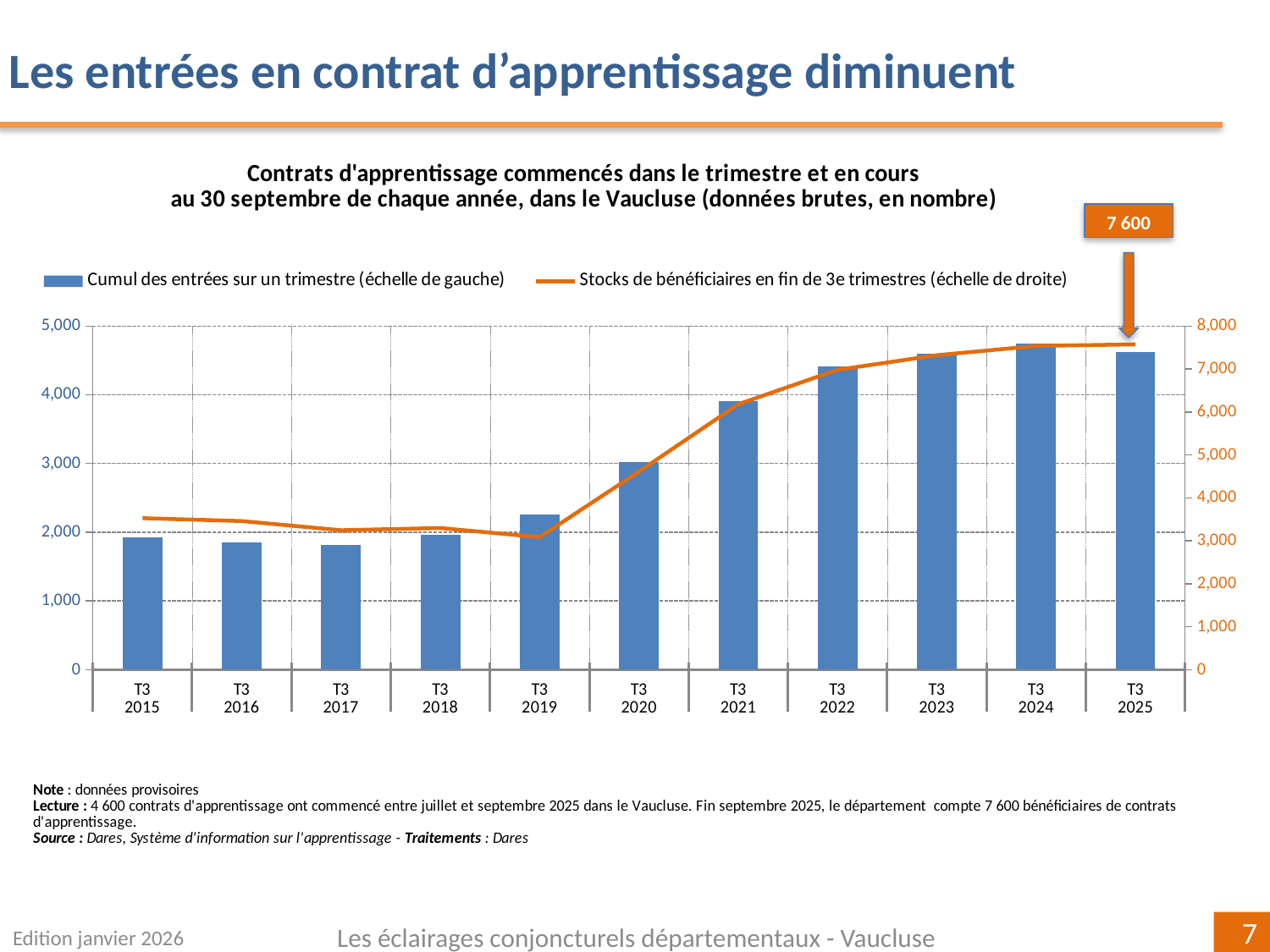
Is the value of 'Cumul des entrées sur un trimestre' for T3 2022 greater or less than 4,000? greater Do the 'Cumul des entrées sur un trimestre' bars rise or fall from T3 2015 to T3 2017? fall Is the value of 'Cumul des entrées sur un trimestre' for T3 2017 greater or less than 2,000? less Which has the larger value for 'Cumul des entrées sur un trimestre': T3 2016 or T3 2021? T3 2021 Does the 'Stocks de bénéficiaires' line rise or fall between T3 2019 and T3 2025? rise Which series is drawn as the orange line? Stocks de bénéficiaires en fin de 3e trimestres (échelle de droite) Is the value of 'Cumul des entrées sur un trimestre' for T3 2019 greater or less than 2,000? greater How many series does the legend list? 2 How many quarters (categories) are shown on the x axis? 11 What is the value of 'Stocks de bénéficiaires en fin de 3e trimestres' at T3 2025? 7 600 What kind of chart is used to plot the series 'Cumul des entrées sur un trimestre (échelle de gauche)'? bar chart